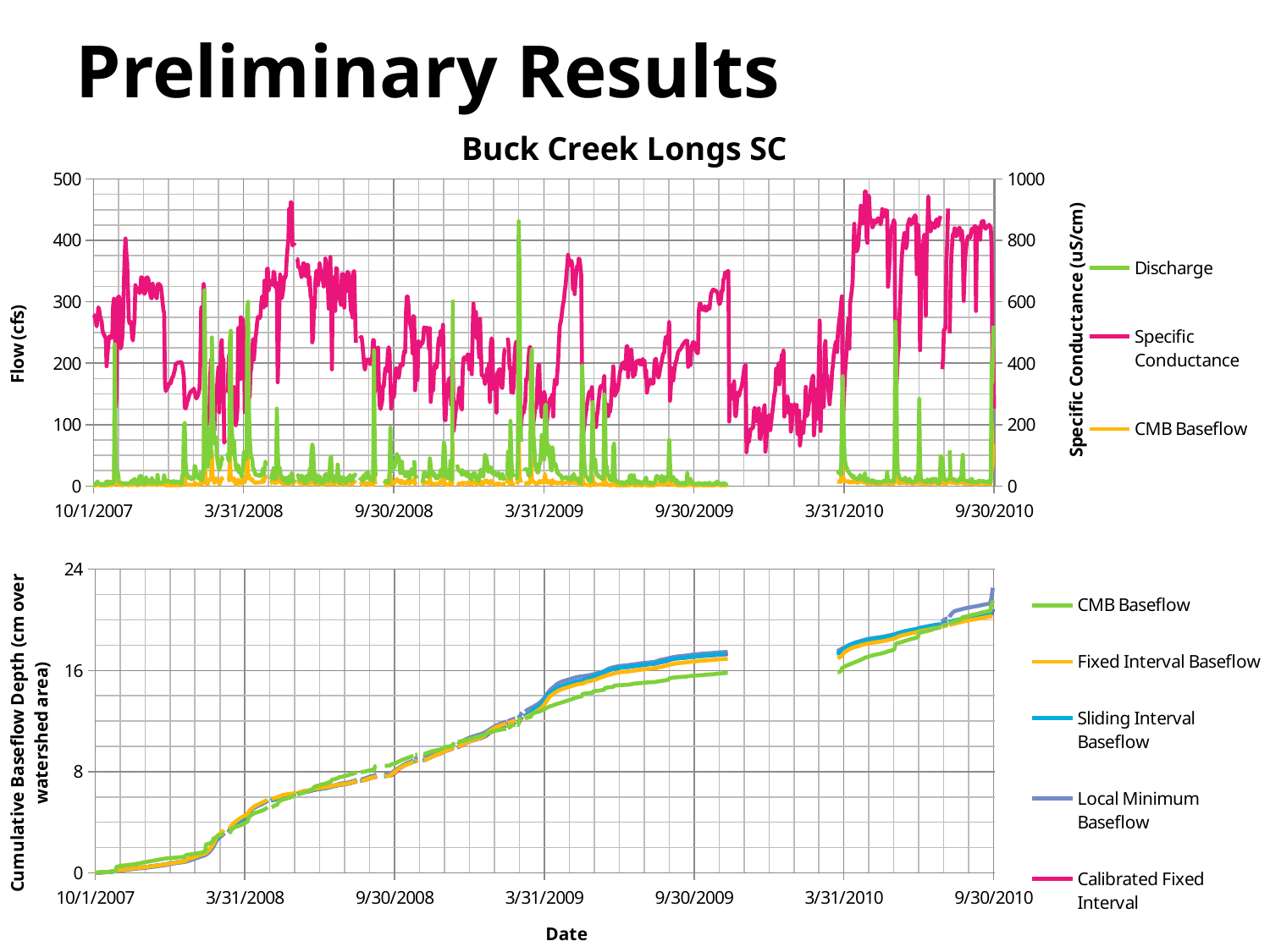
In the top chart, is the Specific Conductance value at 10/1/2007 greater or less than 400 uS/cm? greater In the bottom chart, which series has the lowest cumulative baseflow depth at 9/30/2009? CMB Baseflow In the top chart, is the peak Discharge value near 3/31/2009 greater or less than 400 cfs? greater In the bottom chart, is the Sliding Interval Baseflow value at 9/30/2009 greater or less than 16? greater What kind of chart is the top chart, Buck Creek Longs SC? line chart In the bottom chart, do the cumulative baseflow depth lines rise or fall along the date axis? rise In the top chart, what is the label of the right-hand vertical axis? Specific Conductance (uS/cm) How many series does the legend of the top chart (Buck Creek Longs SC) list? 3 How many series does the legend of the bottom chart (Cumulative Baseflow Depth) list? 5 What is the title of the top chart? Buck Creek Longs SC